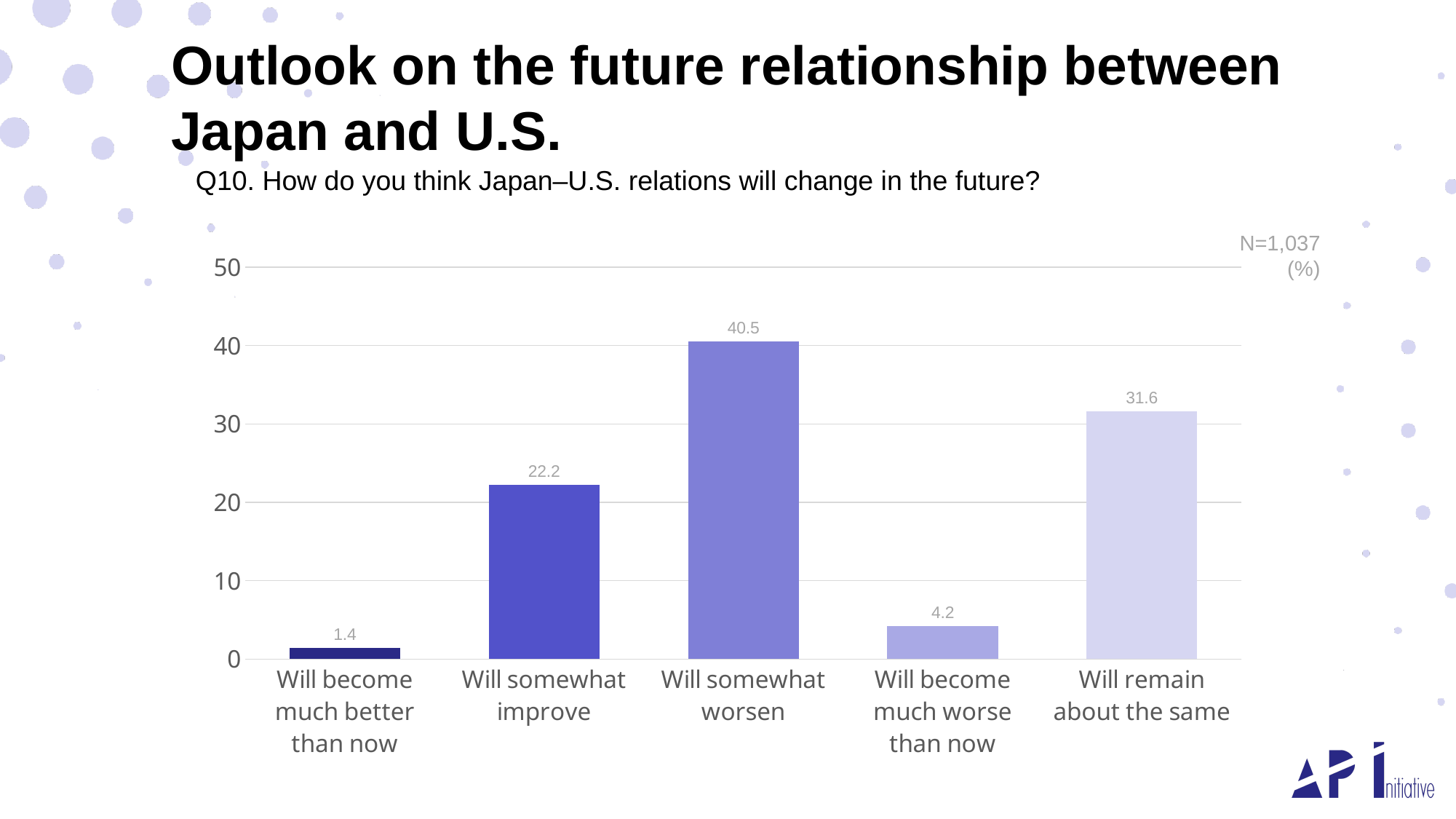
How many categories are shown on the x axis? 5 What is the difference between "Will somewhat worsen" and "Will somewhat improve"? 18.3 Which category has the lowest value? Will become much better than now What is the difference between "Will become much worse than now" and "Will become much better than now"? 2.8 What is the value for "Will become much better than now"? 1.4 What is the value for "Will somewhat worsen"? 40.5 Which category has the highest value? Will somewhat worsen What kind of chart is shown on the slide? Bar chart Is the value for "Will somewhat worsen" greater or less than 40? greater What sample size (N) is shown on the chart? N=1,037 What is the value for "Will remain about the same"? 31.6 Which is larger, "Will somewhat improve" or "Will remain about the same"? Will remain about the same